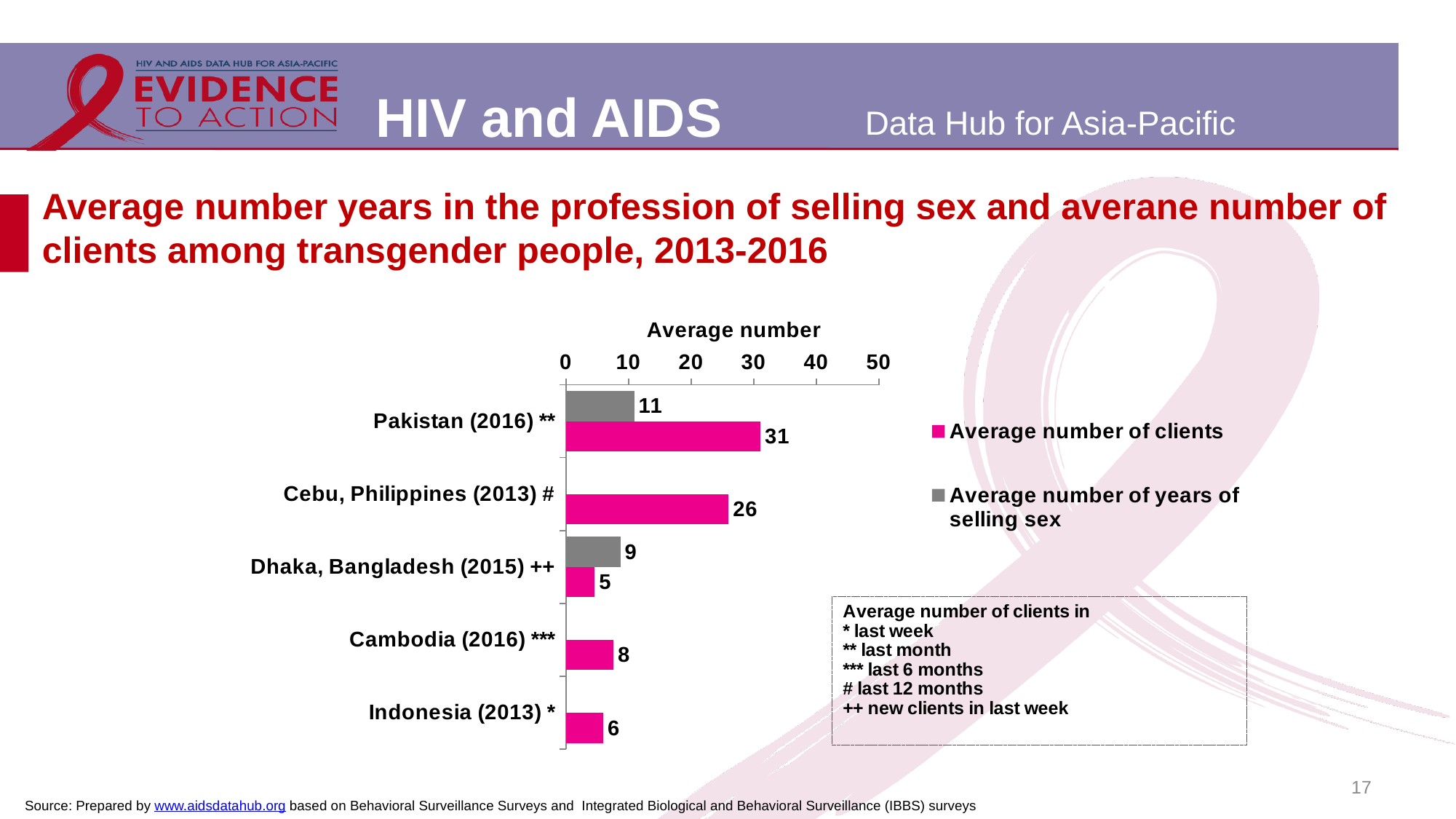
What is the average number of clients for Cebu, Philippines (2013) #? 26 What is the average number of years of selling sex for Dhaka, Bangladesh (2015) ++? 9 How many series does the legend list? 2 What is the average number of clients for Indonesia (2013) *? 6 How many categories are shown on the y axis of the chart? 5 Which category has the lowest average number of clients? Dhaka, Bangladesh (2015) ++ Which is larger for Dhaka, Bangladesh (2015) ++: the average number of clients or the average number of years of selling sex? Average number of years of selling sex What kind of chart is shown on the slide? Bar chart What is the average number of years of selling sex for Pakistan (2016) **? 11 What is the difference between the average number of clients for Pakistan (2016) ** and Cebu, Philippines (2013) #? 5 What is the average number of clients for Pakistan (2016) **? 31 Which category has the highest average number of clients? Pakistan (2016) **